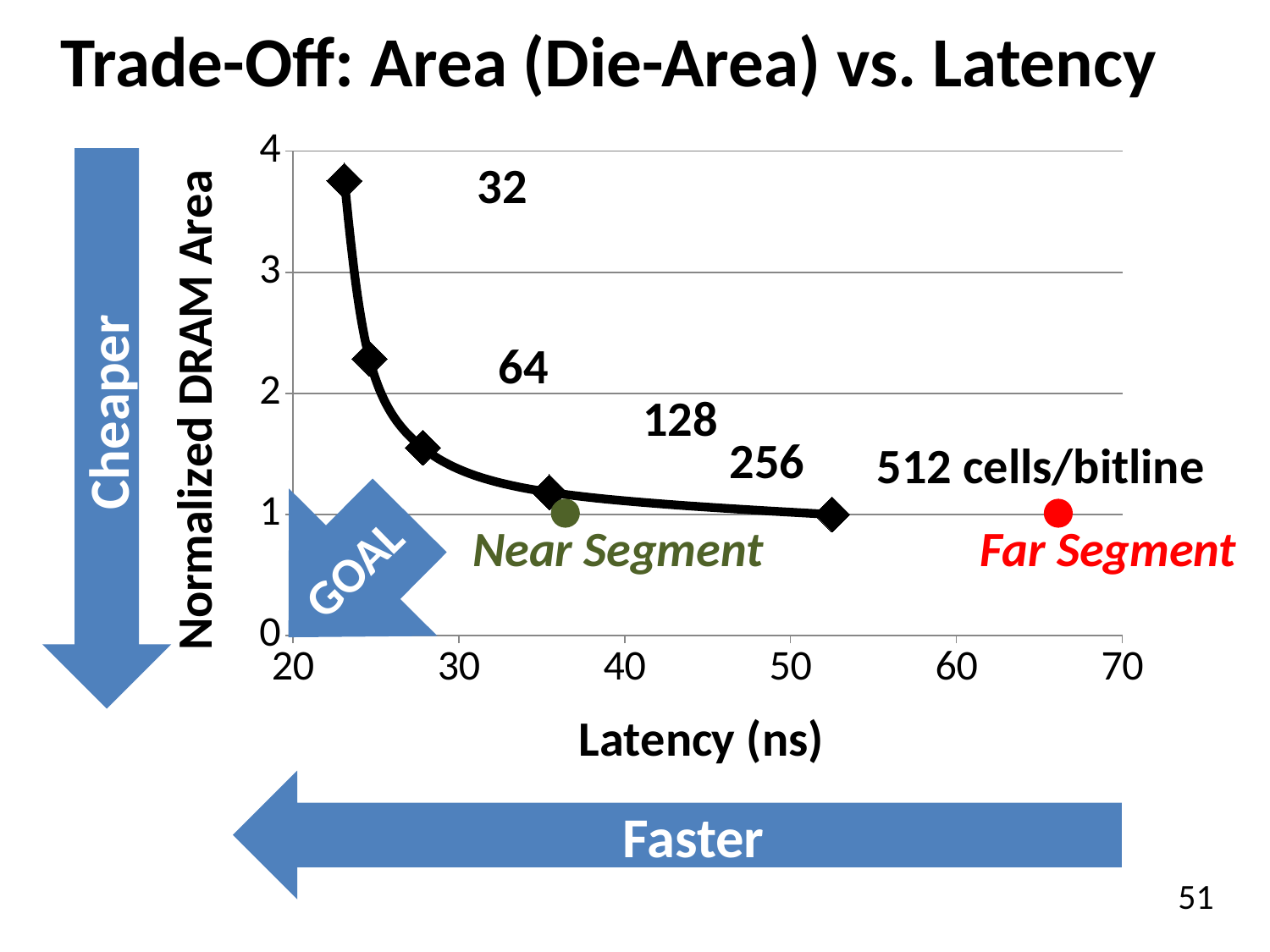
What is the title of the slide's chart? Trade-Off: Area (Die-Area) vs. Latency Is the latency of the Far Segment point greater or less than 60 ns? greater Which cells/bitline configuration has the lowest Normalized DRAM Area? 512 Which cells/bitline configuration has the highest Normalized DRAM Area? 32 Which has a higher Normalized DRAM Area, 64 cells/bitline or 256 cells/bitline? 64 cells/bitline Is the Normalized DRAM Area for 128 cells/bitline greater or less than 2? less Is the latency for 512 cells/bitline greater or less than 50 ns? greater As latency increases along the x axis, does the Normalized DRAM Area rise or fall? fall What is the label of the x axis? Latency (ns) How many black diamond data points are plotted on the curve? 5